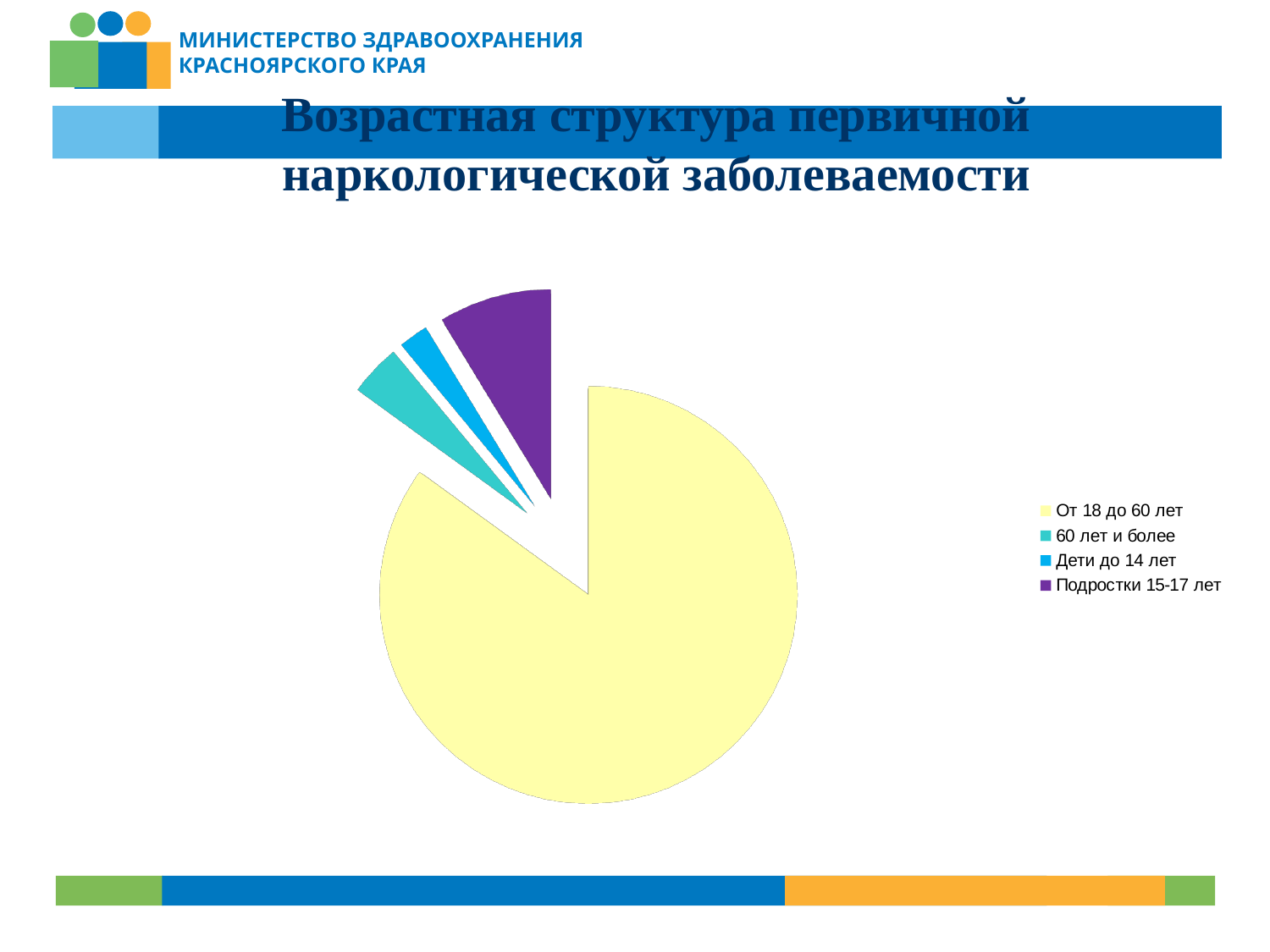
Which category has the smallest slice of the pie chart? Дети до 14 лет Which slice is larger: Подростки 15-17 лет or Дети до 14 лет? Подростки 15-17 лет Which slice is larger: Подростки 15-17 лет or 60 лет и более? Подростки 15-17 лет What kind of chart is shown on the slide? pie chart How many categories (slices) does the pie chart have? 4 What is the title of the chart on the slide? Возрастная структура первичной наркологической заболеваемости Which category is shown in purple in the pie chart? Подростки 15-17 лет Which slice is larger: От 18 до 60 лет or 60 лет и более? От 18 до 60 лет Which category has the largest slice of the pie chart? От 18 до 60 лет How many entries does the legend of the pie chart list? 4